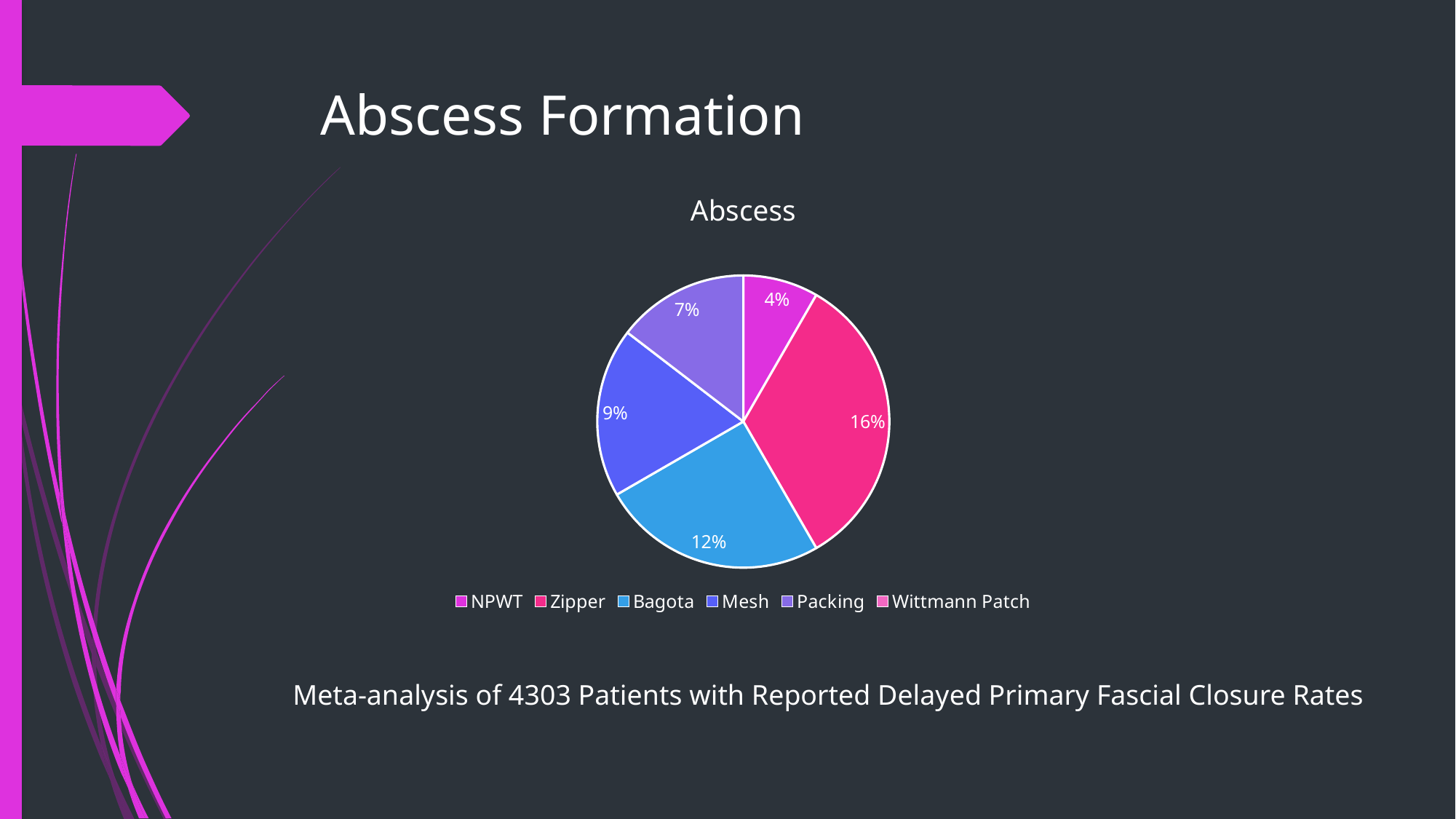
Which labelled slice is the smallest in the Abscess pie chart? NPWT What is the value shown for Zipper in the Abscess pie chart? 16% What is the value shown for Mesh in the Abscess pie chart? 9% What is the value shown for Bagota in the Abscess pie chart? 12% What is the value shown for NPWT in the Abscess pie chart? 4% What is the value shown for Packing in the Abscess pie chart? 7% What kind of chart is shown on the slide? Pie chart How many entries does the legend of the Abscess chart list? 6 What is the title of the chart on the slide? Abscess Which has a larger value in the Abscess pie chart, Mesh or Packing? Mesh Which category has the largest slice in the Abscess pie chart? Zipper What is the difference between the values for Zipper and Bagota in the Abscess pie chart? 4%